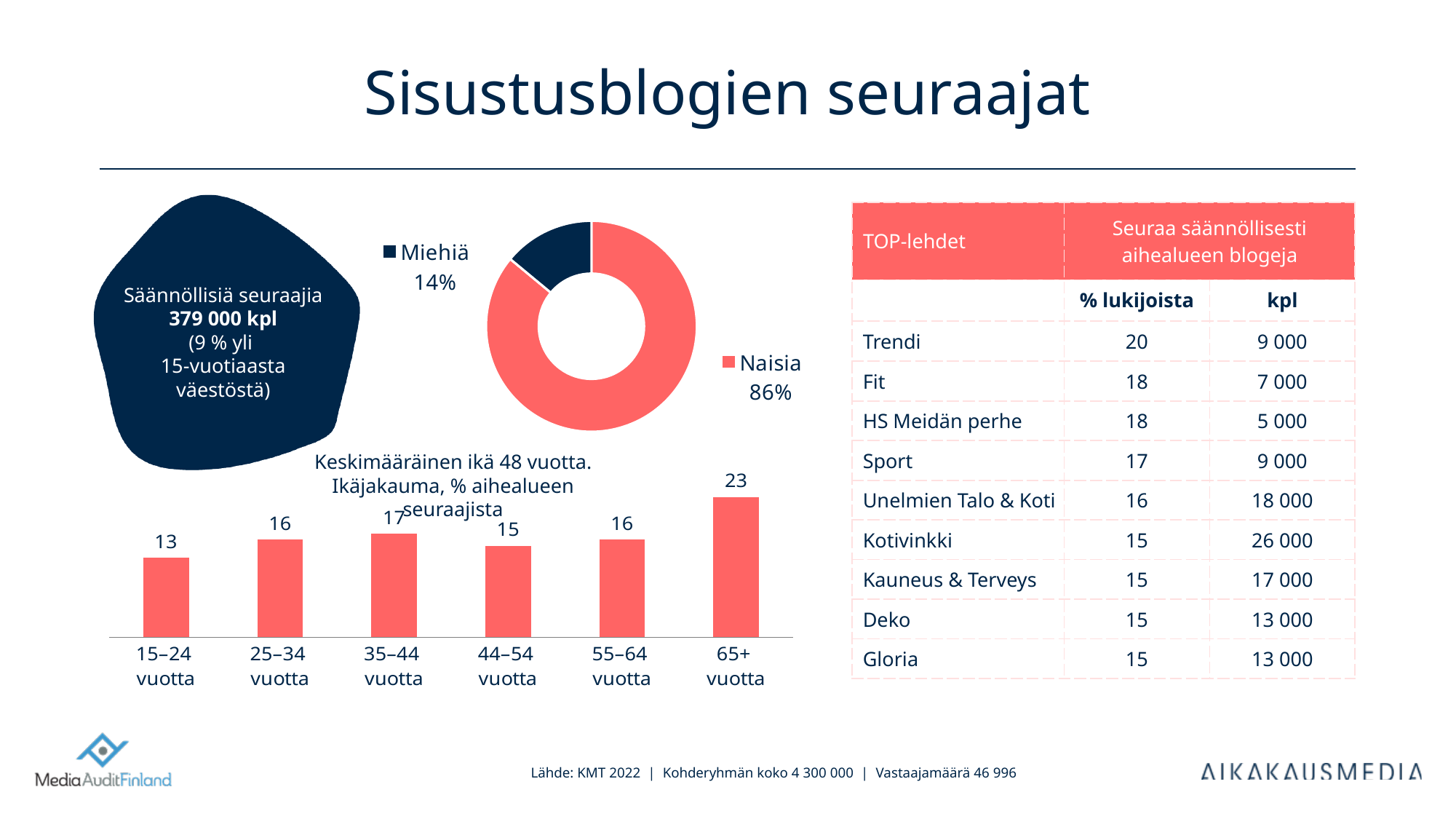
How many age groups are shown in the age distribution bar chart? 6 In the age distribution bar chart, which age group has the lowest value? 15–24 vuotta In the age distribution bar chart, which age group has the highest value? 65+ vuotta How many categories does the donut chart show? 2 In the donut chart, what share of followers are women (Naisia)? 86% What kind of chart is the age distribution chart at the bottom? Bar chart What kind of chart is the gender chart on the left? Donut chart In the donut chart, what share of followers are men (Miehiä)? 14% In the donut chart, which group has the larger share, Miehiä or Naisia? Naisia In the age distribution bar chart, what is the value for 65+ vuotta? 23 In the age distribution bar chart, what is the value for 15–24 vuotta? 13 In the age distribution bar chart, what is the difference between the values for 65+ vuotta and 35–44 vuotta? 6